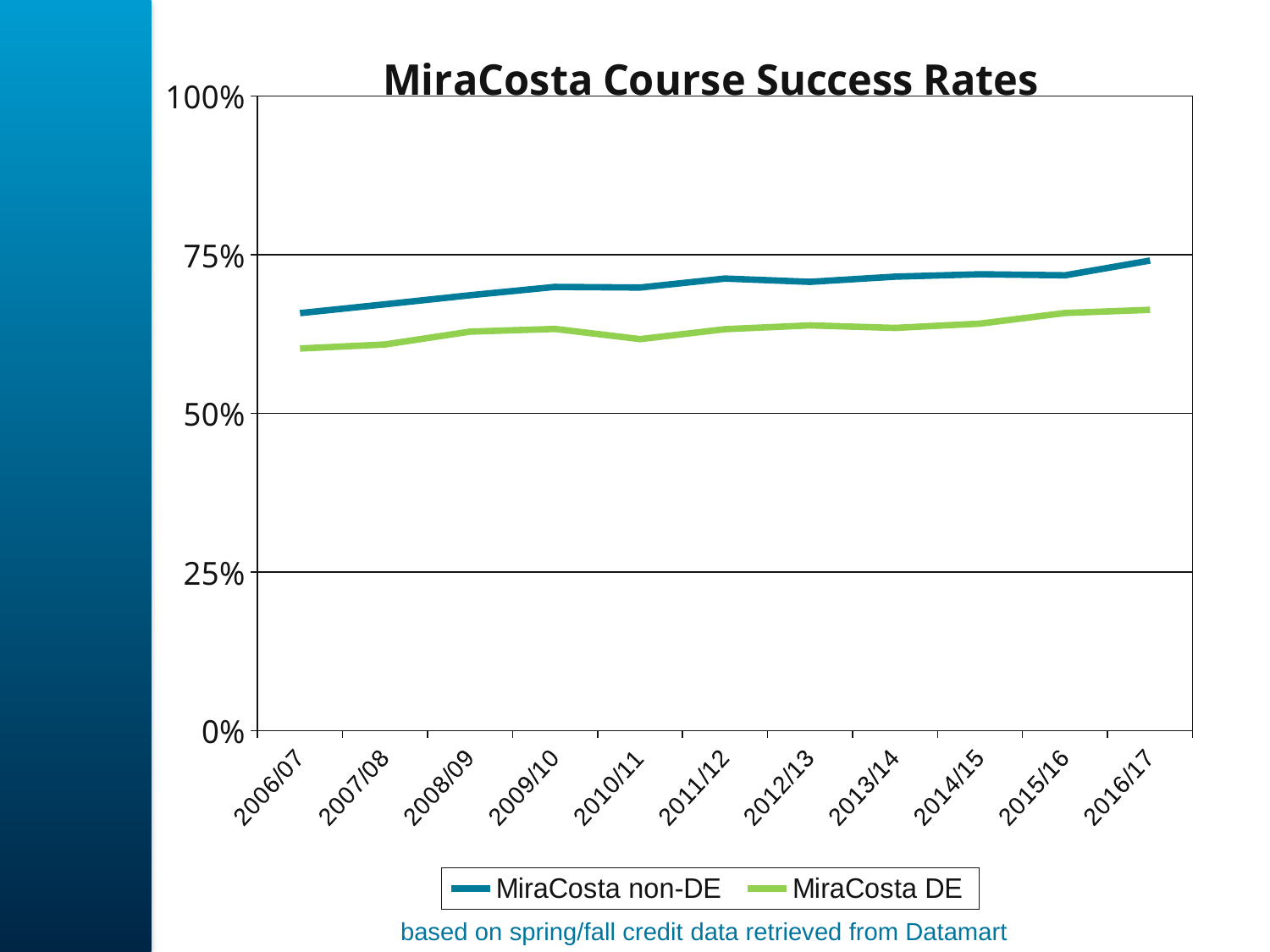
Is the value for MiraCosta DE in 2016/17 greater or less than 75%? less How many academic years are plotted along the x axis? 11 What kind of chart is shown on the slide? line chart What is the title of the chart? MiraCosta Course Success Rates Is the value for MiraCosta non-DE in 2006/07 greater or less than 75%? less In which year is the MiraCosta non-DE success rate highest? 2016/17 Which series is drawn in green? MiraCosta DE How many series does the legend list? 2 Is the value for MiraCosta DE in 2006/07 greater or less than 50%? greater Which series has the higher value in 2010/11, MiraCosta non-DE or MiraCosta DE? MiraCosta non-DE Does the MiraCosta non-DE success rate generally rise or fall from 2006/07 to 2016/17? rise In which year is the MiraCosta DE success rate lowest? 2006/07